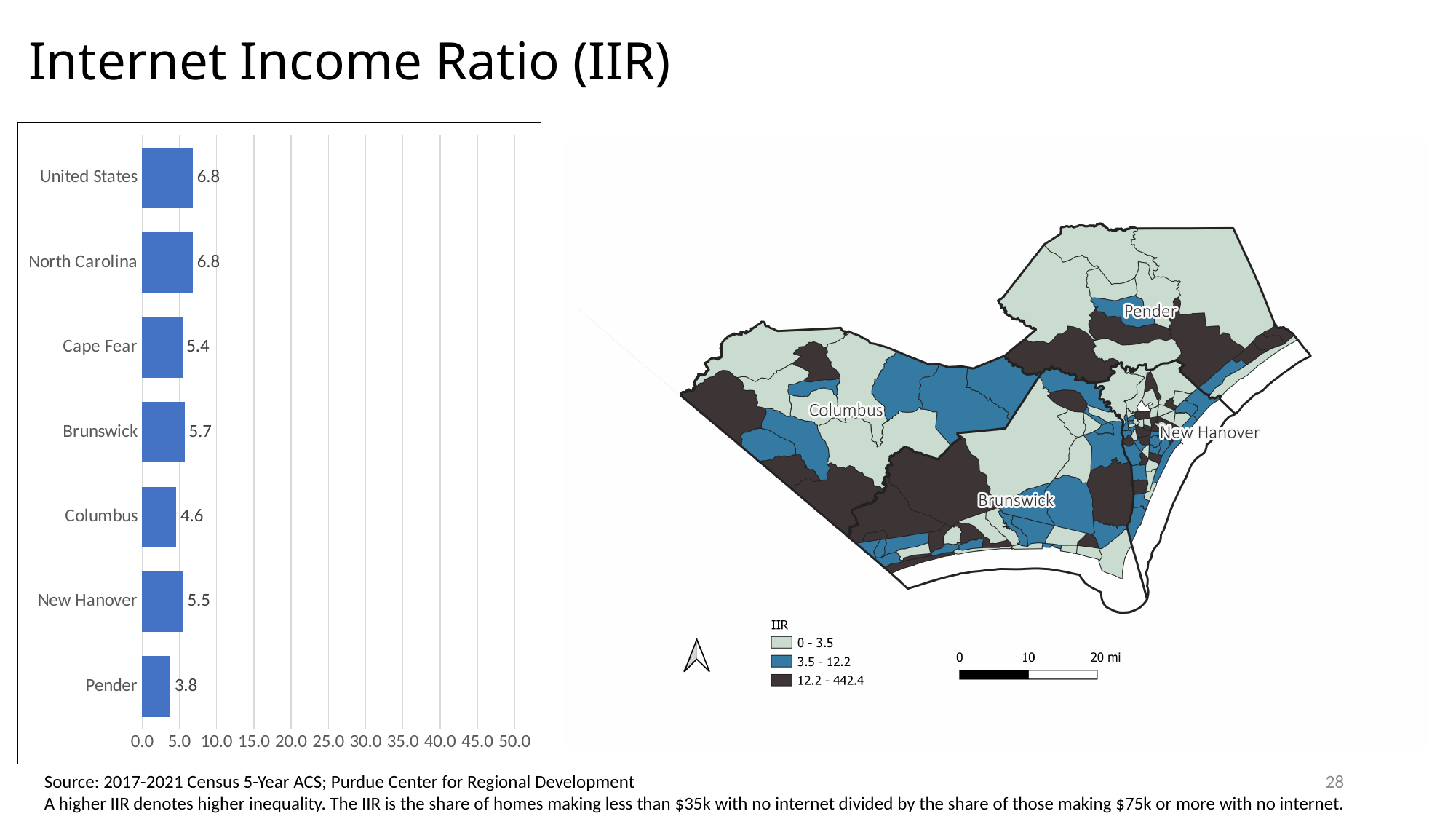
What is the highest value shown on the x axis of the bar chart? 50.0 How many categories are shown in the bar chart? 7 In the bar chart, is the value for Pender greater or less than 5.0? less What is the Internet Income Ratio for Columbus in the bar chart? 4.6 In the bar chart, which has a higher Internet Income Ratio, Brunswick or Columbus? Brunswick What is the Internet Income Ratio for Cape Fear in the bar chart? 5.4 What is the difference between the Internet Income Ratio for the United States and for Pender in the bar chart? 3.0 Which category has the lowest Internet Income Ratio in the bar chart? Pender What is the Internet Income Ratio for New Hanover in the bar chart? 5.5 What kind of chart is shown on the left of the slide? bar chart What is the difference between the Internet Income Ratio for Brunswick and for Columbus in the bar chart? 1.1 What is the Internet Income Ratio for North Carolina in the bar chart? 6.8